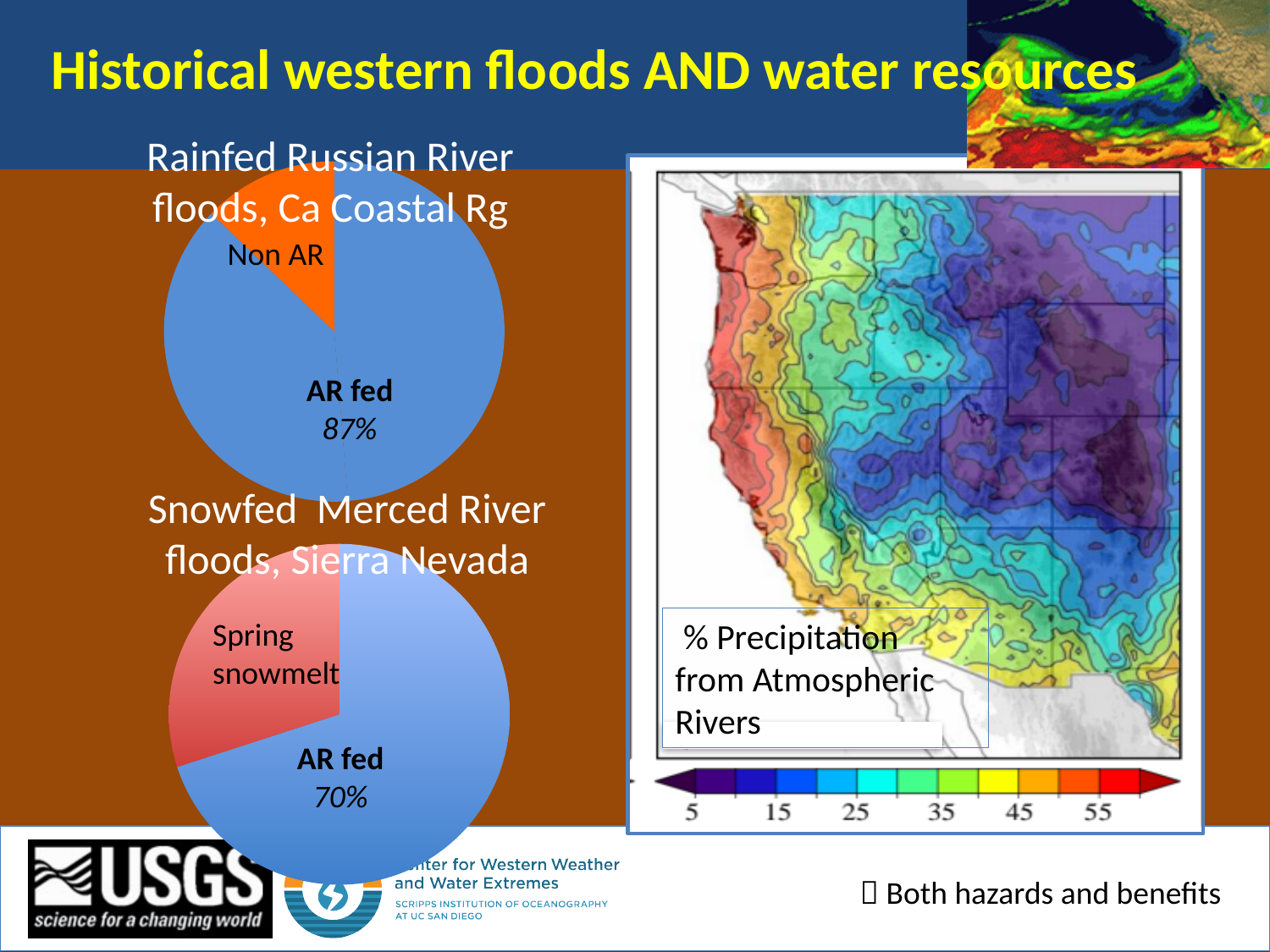
In the Snowfed Merced River floods pie chart, which slice is the smallest? Spring snowmelt In the Rainfed Russian River floods pie chart, what is the label of the slice that is not AR fed? Non AR In the Snowfed Merced River floods pie chart, what colour is the AR fed slice? Blue In the Rainfed Russian River floods pie chart, which slice is the largest? AR fed How many percentage points larger is the AR fed share in the Rainfed Russian River floods pie chart than in the Snowfed Merced River floods pie chart? 17 percentage points How many slices does the Snowfed Merced River floods pie chart have? 2 In the Rainfed Russian River floods pie chart, what share of floods is AR fed? 87% What kind of chart is used for the Snowfed Merced River floods data? Pie chart What kind of chart is used for the Rainfed Russian River floods data? Pie chart In the Snowfed Merced River floods pie chart, what share of floods is AR fed? 70% Which pie chart shows a larger AR fed share, Rainfed Russian River floods or Snowfed Merced River floods? Rainfed Russian River floods